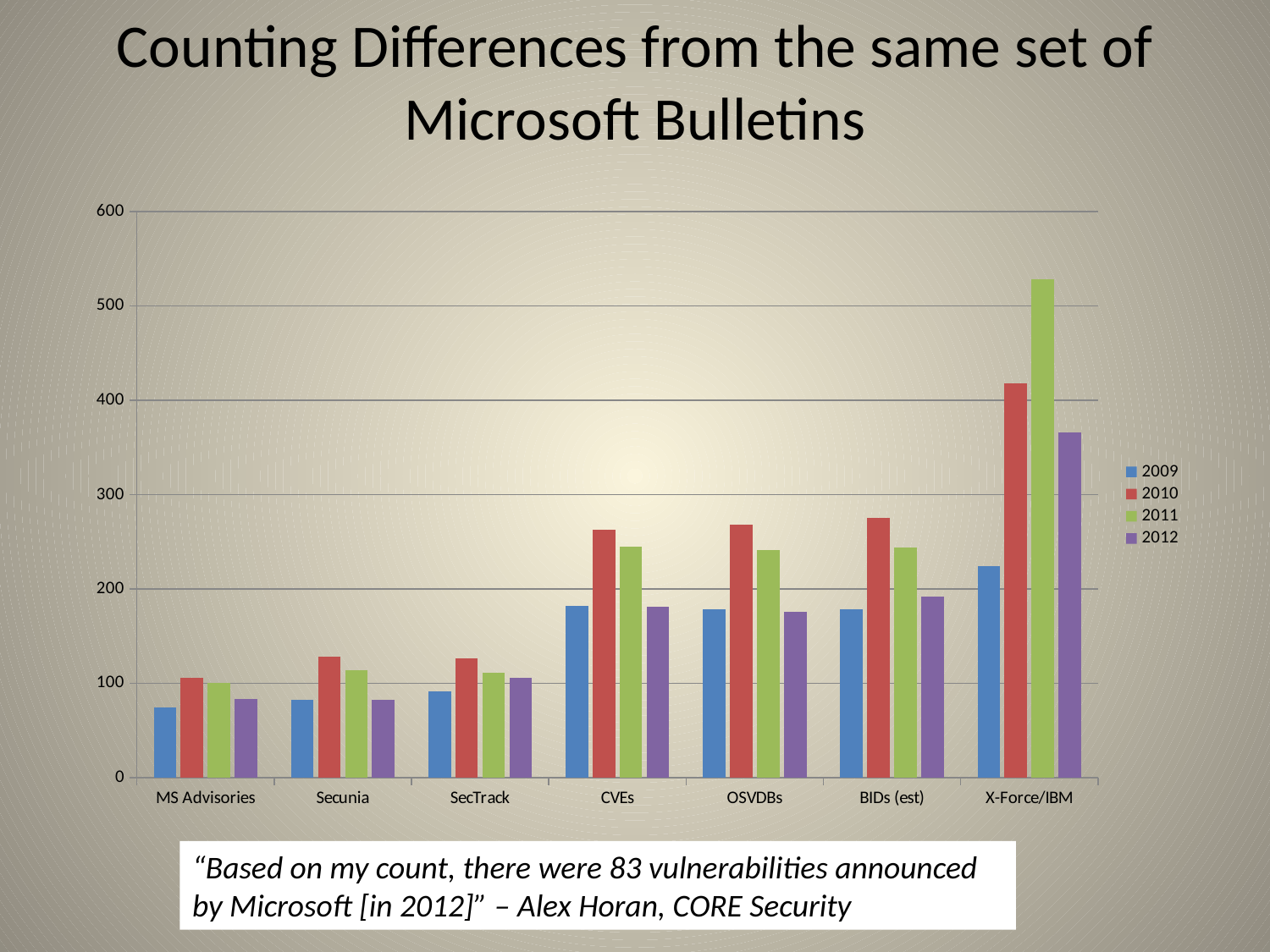
Which category has the highest value for the 2011 series? X-Force/IBM Is the 2011 value for X-Force/IBM greater or less than 500? greater Is the 2010 value for CVEs greater or less than 200? greater Is the 2009 value for MS Advisories greater or less than 100? less How many categories are shown on the x axis of the chart? 7 Which category has the lowest value for the 2009 series? MS Advisories What is the title of the slide containing the chart? Counting Differences from the same set of Microsoft Bulletins What kind of chart is shown on the slide? bar chart How many series does the chart's legend list? 4 For CVEs, which is larger: the 2010 value or the 2012 value? 2010 For X-Force/IBM, which year has the highest bar? 2011